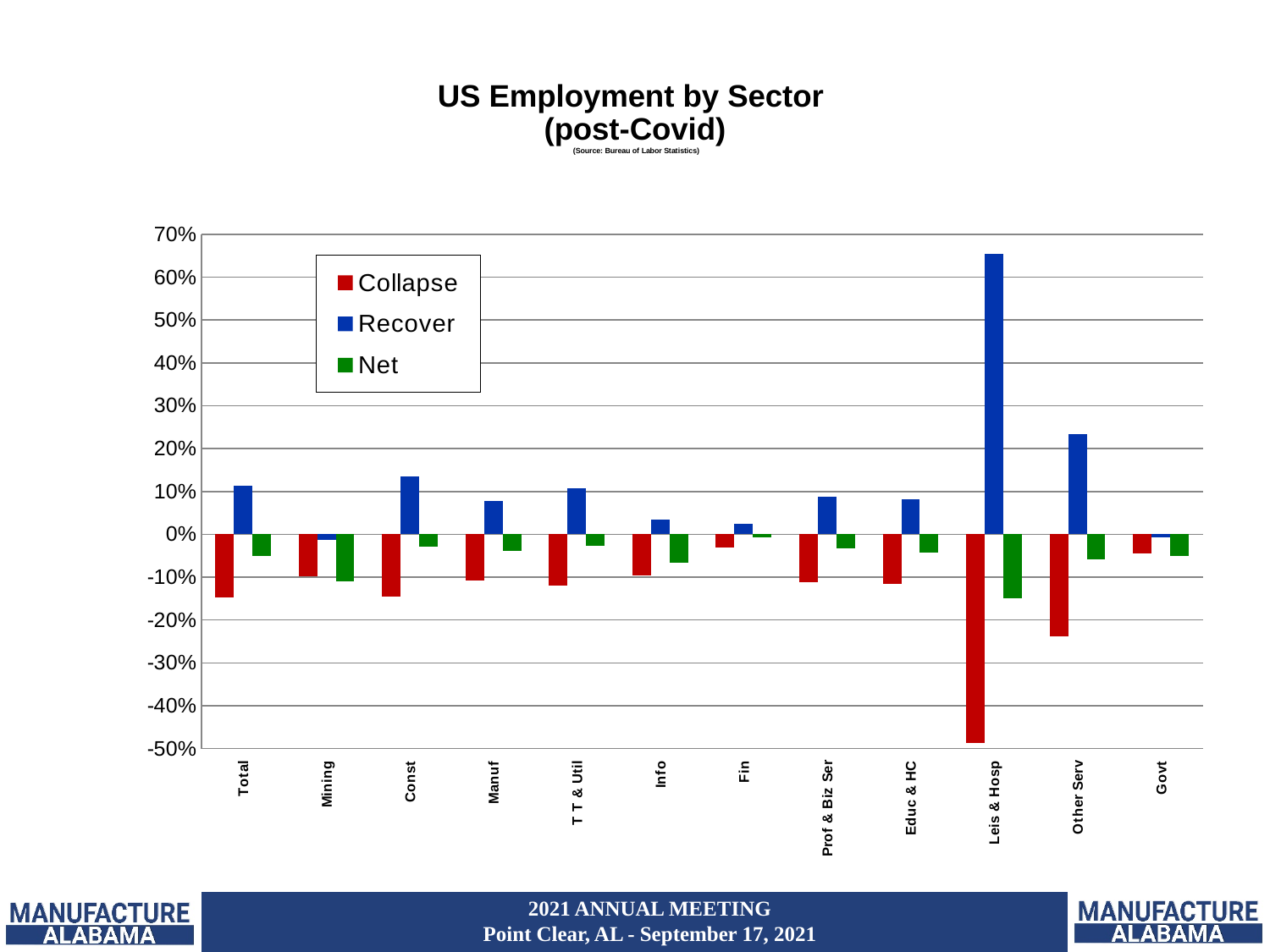
Is the Recover value for Leis & Hosp greater or less than 60%? greater How many sector categories are shown on the x axis? 12 How many series does the legend list? 3 What colour represents the Net series in the legend? green What kind of chart is shown on the slide? bar chart Is the Collapse value for Total greater or less than -10%? less Which sector has the lowest Collapse value? Leis & Hosp Which sector has the highest Recover value? Leis & Hosp Which sector has the lowest Net value? Leis & Hosp Which has the larger Recover value, Const or Manuf? Const Is the Collapse value for Leis & Hosp greater or less than -40%? less